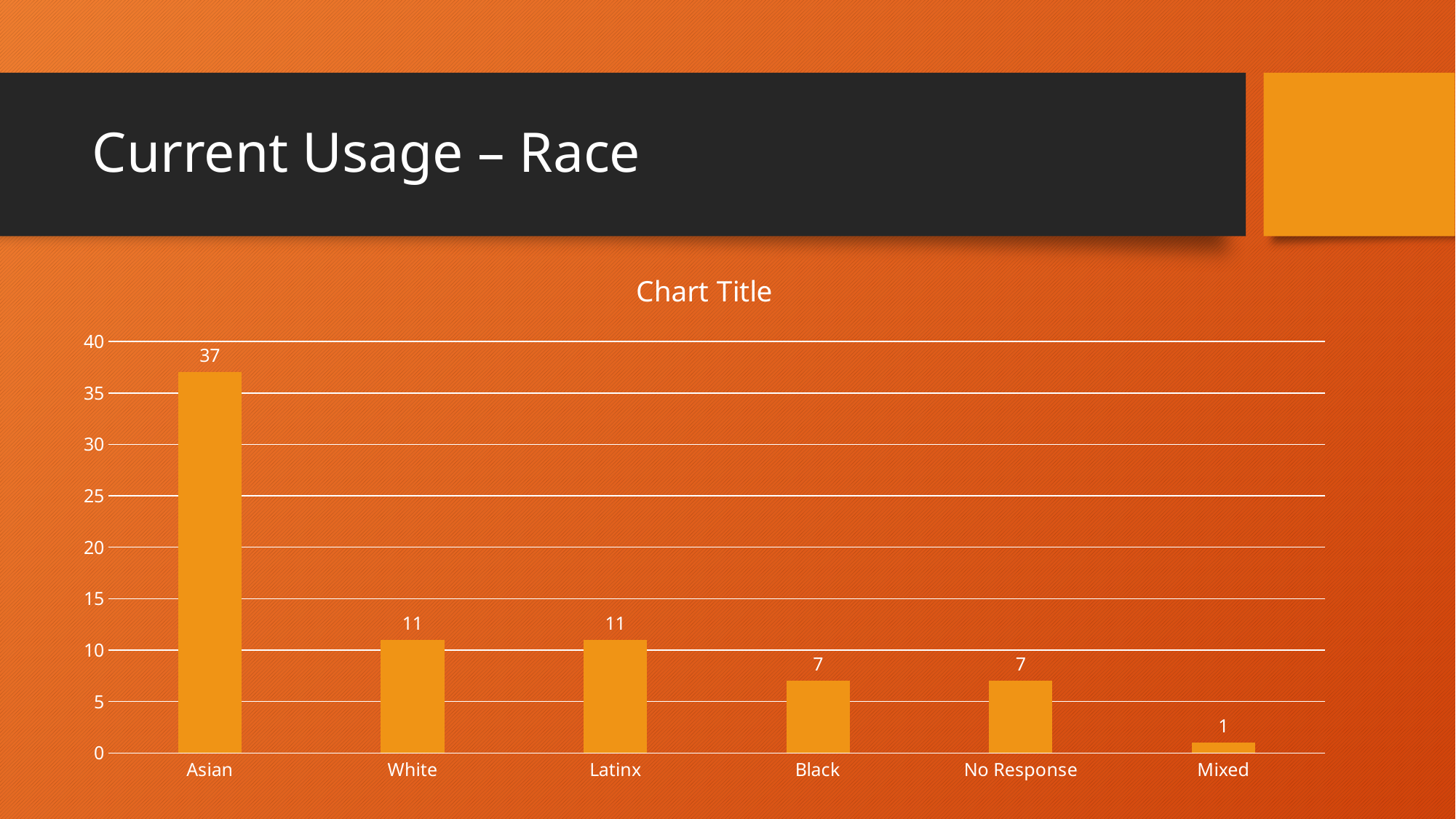
How many categories are shown on the x axis? 6 What is the value for White? 11 Is the value for Asian greater or less than 35? greater What is the difference between the values for Asian and Latinx? 26 What is the value for Mixed? 1 What is the value for Asian? 37 What kind of chart is shown on the slide? Bar chart What is the value for Black? 7 What is the title shown above the chart? Chart Title Which is larger, the value for White or the value for No Response? White Which category has the lowest value? Mixed Which category has the highest value? Asian